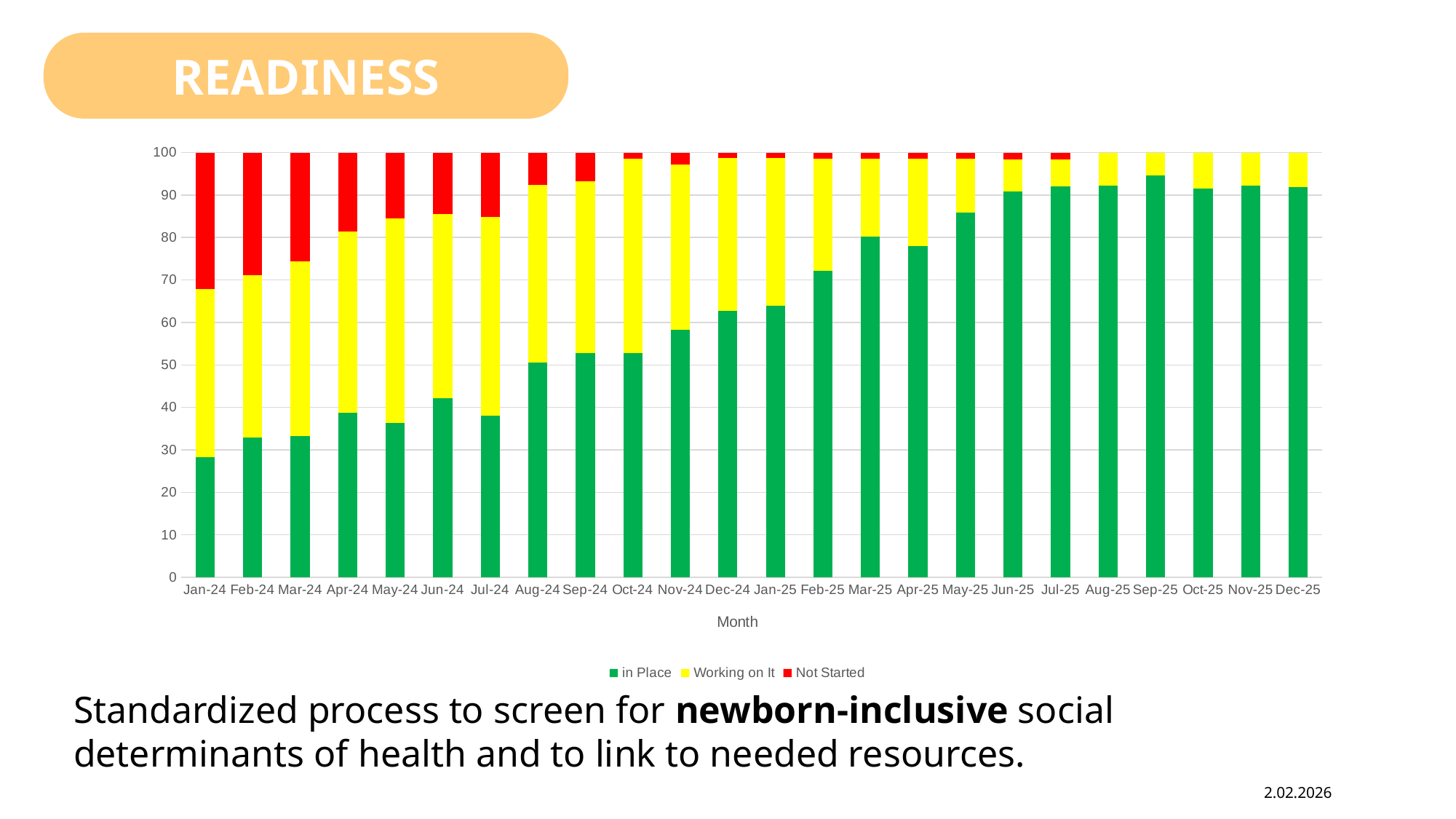
Which has the larger 'Not Started' segment, Jan-24 or Jul-24? Jan-24 What is the x-axis title? Month What is the total height of the stacked bar for Jan-24? 100 What are the three legend entries? in Place, Working on It, Not Started How many series does the legend list? 3 How many months are plotted along the x axis? 24 Which month has the highest 'in Place' value? Sep-25 Does the 'in Place' series generally rise or fall from Jan-24 to Dec-25? rise Which month has the lowest 'in Place' value? Jan-24 Is the 'in Place' value for Jan-24 greater or less than 30? less What kind of chart is shown on the slide? Stacked bar chart Is the 'in Place' value for Mar-25 greater or less than 70? greater